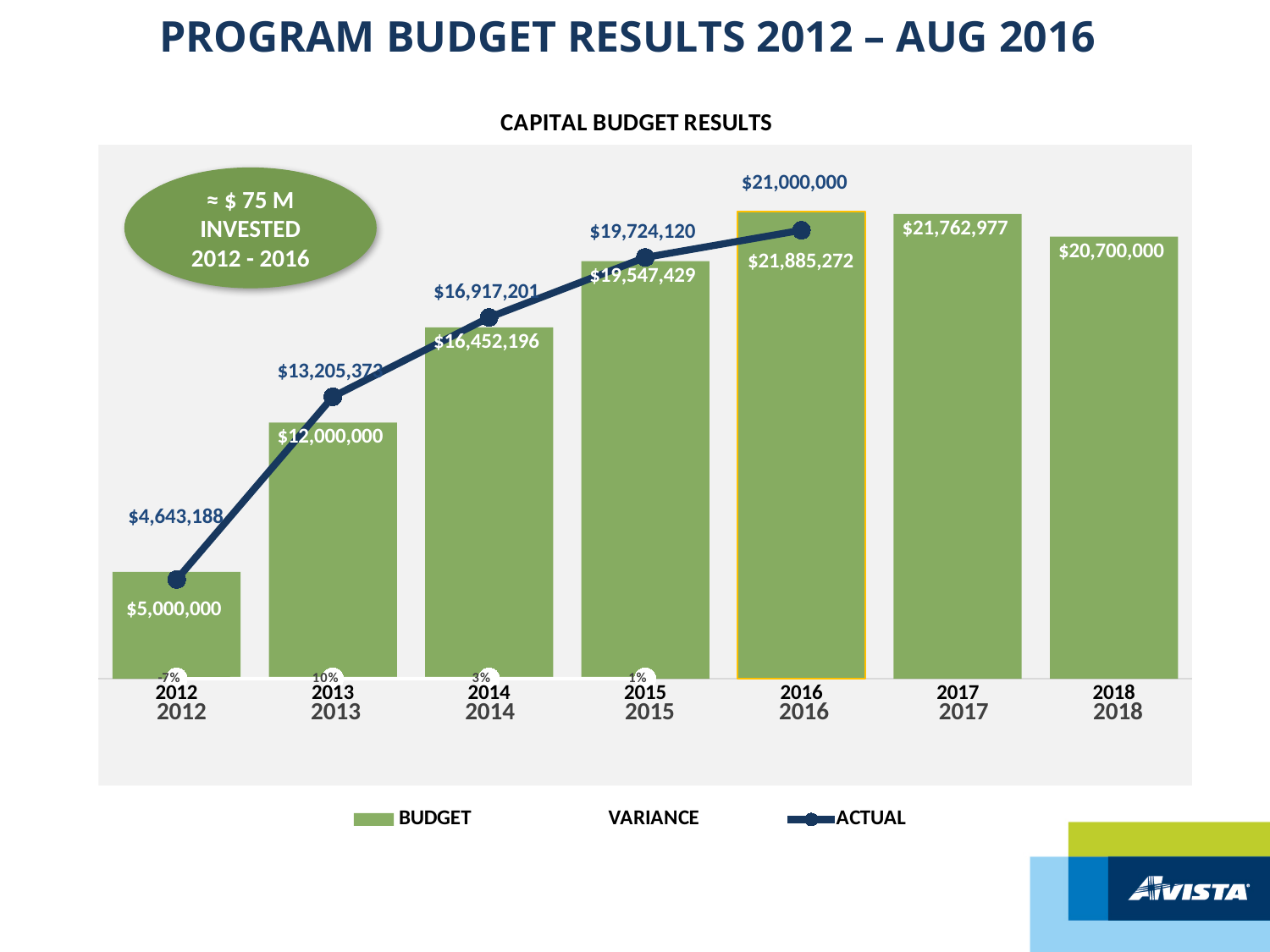
What is the difference between the ACTUAL and BUDGET values for 2014? $465,005 Do the BUDGET bars rise or fall from 2012 to 2016? rise How many series does the legend list? 3 What is the difference between the BUDGET and ACTUAL values for 2016? $885,272 What is the BUDGET value for 2018? $20,700,000 Which year has the highest BUDGET value? 2016 What is the BUDGET value for 2016? $21,885,272 Which is larger for 2012, the BUDGET value or the ACTUAL value? BUDGET How many years are shown on the x axis? 7 What is the ACTUAL value for 2012? $4,643,188 Which year has the lowest BUDGET value? 2012 What is the ACTUAL value for 2015? $19,724,120